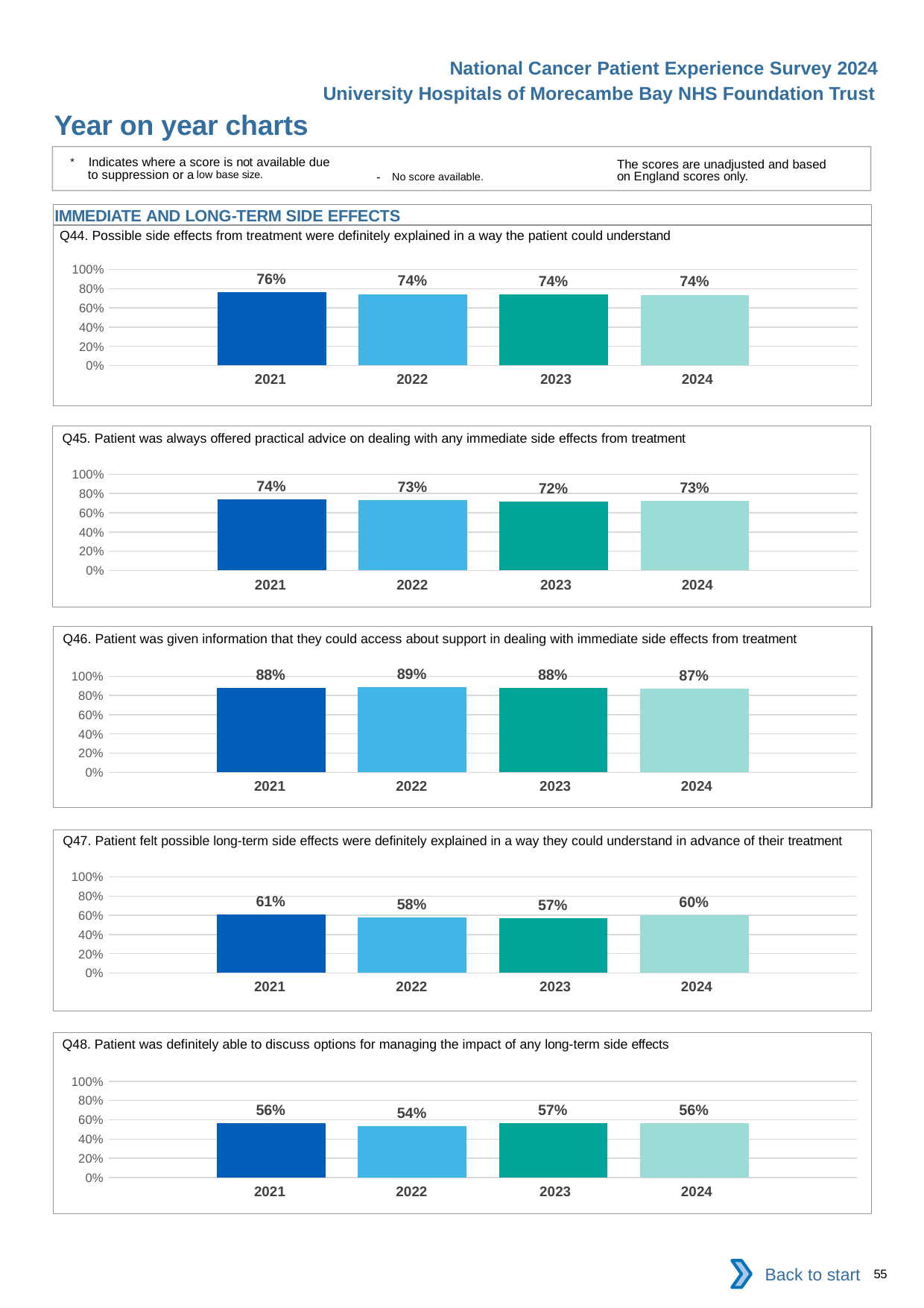
In the Q46 chart, which year has the highest value? 2022 How many years are shown in the Q44 chart? 4 In the Q45 chart, which year has the lowest value? 2023 What kind of chart is the Q45 chart? bar chart In the Q44 chart, what is the value for 2021? 76% In the Q46 chart, is the value for 2024 greater or less than 80%? greater In the Q48 chart, what is the value for 2022? 54% In the Q47 chart, which is larger, the value for 2022 or the value for 2024? 2024 In the Q48 chart, what is the difference between the 2023 value and the 2022 value? 3% How many charts are shown on the slide? 5 In the Q47 chart, does the value rise or fall from 2021 to 2023? fall In the Q47 chart, what is the difference between the 2021 value and the 2023 value? 4%